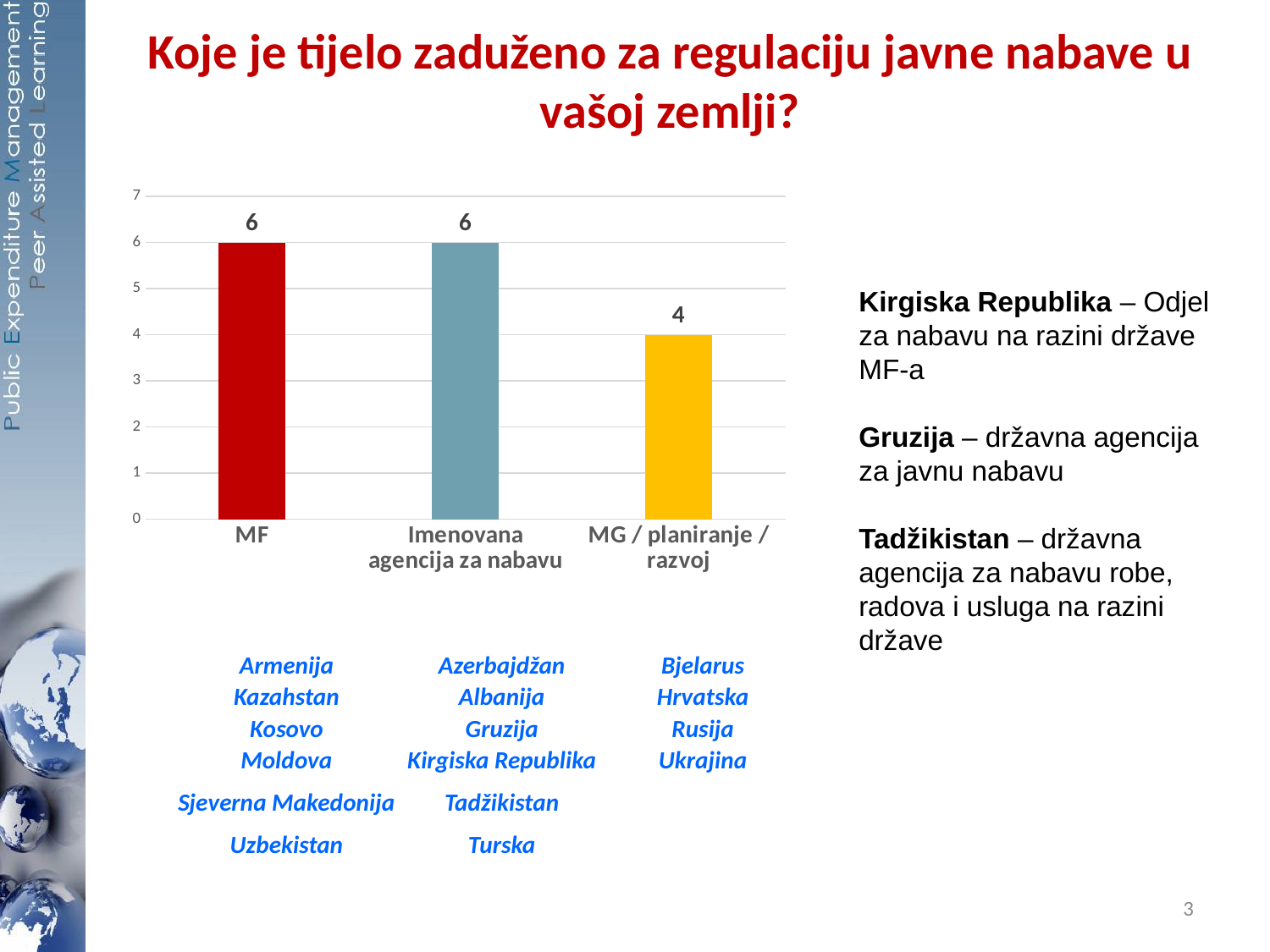
What is the highest value shown on the y axis of the chart? 7 Which is larger, the value for Imenovana agencija za nabavu or the value for MG / planiranje / razvoj? Imenovana agencija za nabavu What is the total of the three bar values in the chart? 16 Which category has the lowest value? MG / planiranje / razvoj What is the difference between the values for MF and MG / planiranje / razvoj? 2 What colour is the bar for MG / planiranje / razvoj? yellow What is the value for Imenovana agencija za nabavu? 6 Is the value for MG / planiranje / razvoj greater or less than 5? less What is the value for MF? 6 What kind of chart is shown on the slide? bar chart What is the value for MG / planiranje / razvoj? 4 How many categories are shown on the x axis of the chart? 3